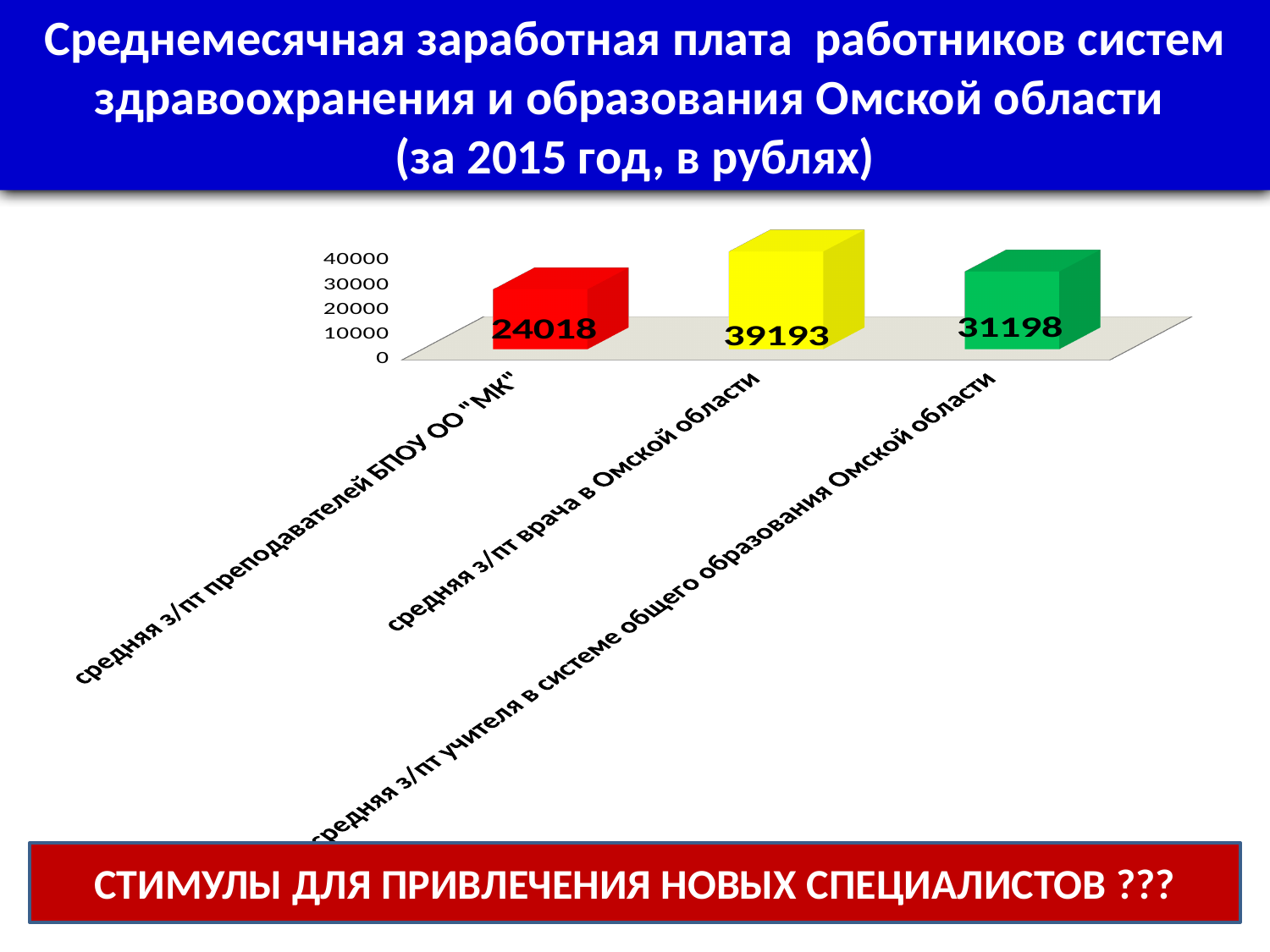
How many categories are plotted on the chart? 3 Is the value for преподавателей БПОУ ОО "МК" greater or less than 30000? less What colour is the bar for средняя з/пт врача в Омской области? yellow What is the difference between the salary of a врач в Омской области and a преподаватель БПОУ ОО "МК"? 15175 Which category has the lowest value on the chart? средняя з/пт преподавателей БПОУ ОО "МК" What kind of chart is shown on the slide? bar chart What is the value shown for средняя з/пт учителя в системе общего образования Омской области? 31198 Which category has the highest value on the chart? средняя з/пт врача в Омской области Which is larger: the salary of a врач в Омской области or a учитель в системе общего образования Омской области? средняя з/пт врача в Омской области What is the value shown for средняя з/пт врача в Омской области? 39193 What is the difference between the salary of a учитель в системе общего образования and a преподаватель БПОУ ОО "МК"? 7180 What is the average monthly salary shown for преподавателей БПОУ ОО "МК"? 24018